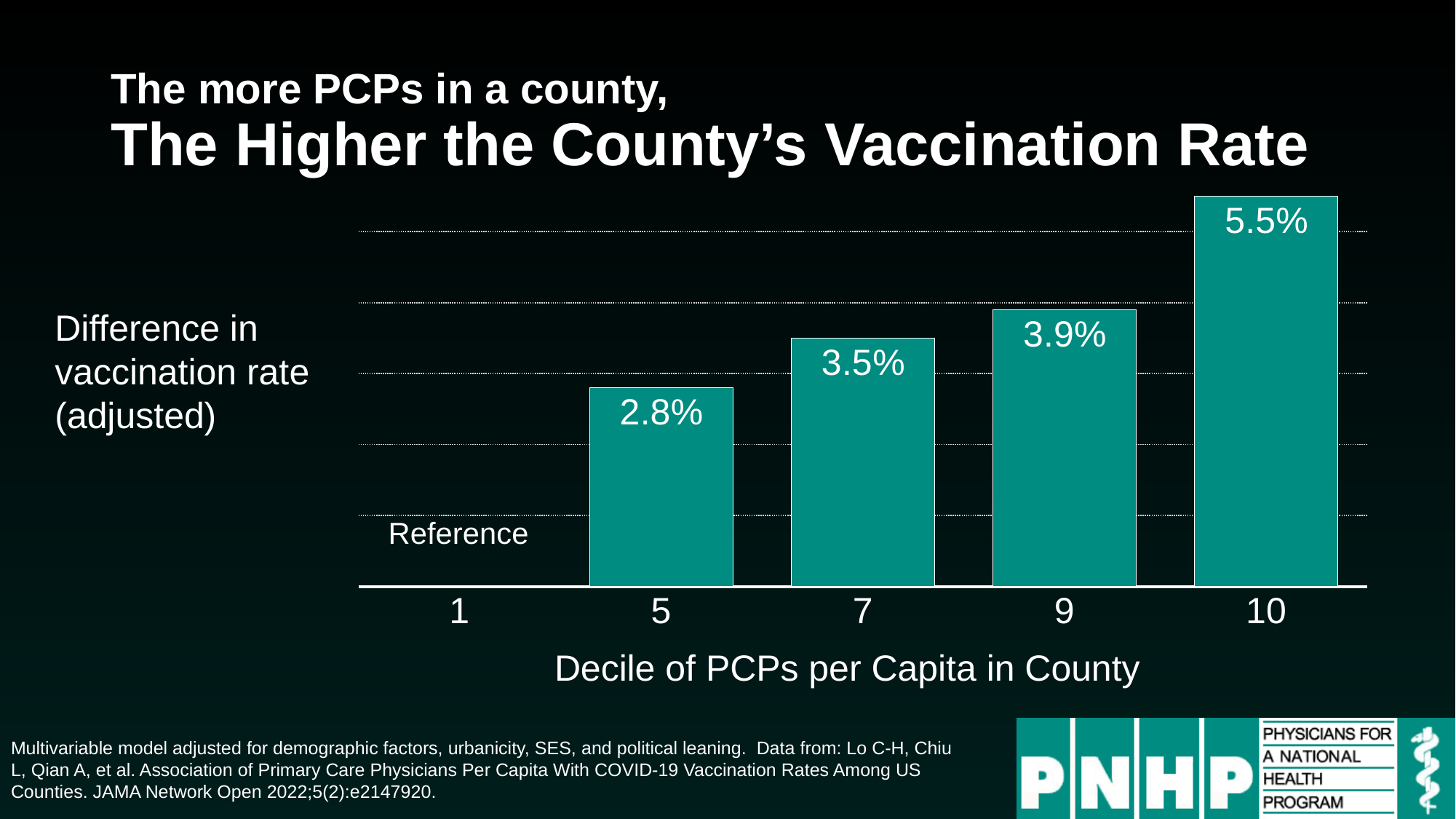
Which decile has the highest difference in vaccination rate? 10 Among the deciles with a plotted bar, which has the lowest difference in vaccination rate? 5 What is the difference in vaccination rate for decile 9? 3.9% Which has a larger difference in vaccination rate, decile 7 or decile 9? 9 What is the difference in vaccination rate for decile 10? 5.5% What is the difference in vaccination rate for decile 7? 3.5% What is the difference between the values for decile 9 and decile 7? 0.4% What is the difference between the values for decile 10 and decile 5? 2.7% What is the difference in vaccination rate for decile 5? 2.8% Do the values rise or fall as the decile of PCPs per capita increases? Rise What kind of chart is shown on the slide? Bar chart How many deciles are labelled on the x axis? 5